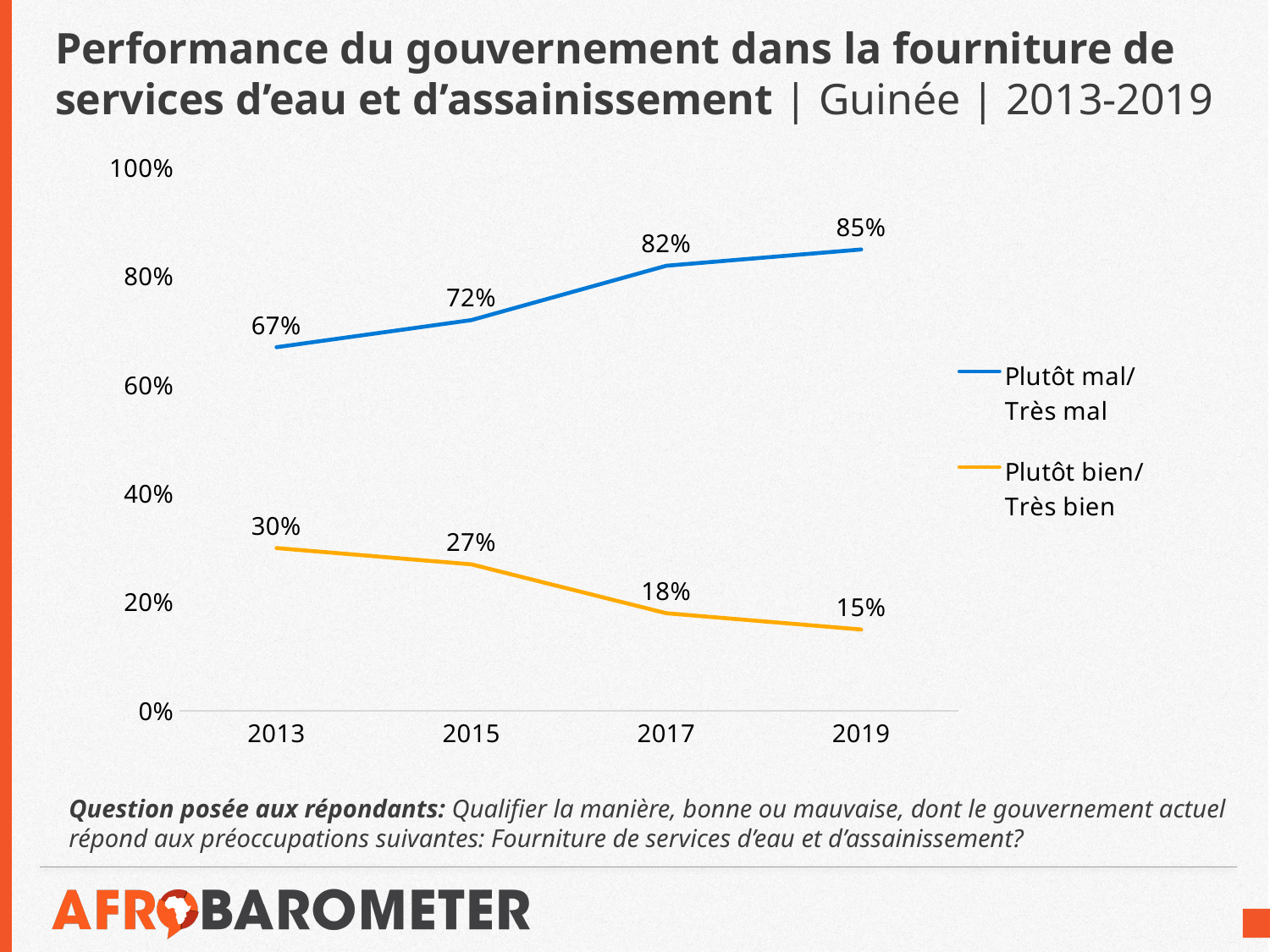
What is the value for 'Plutôt bien/Très bien' in 2013? 30% How many years are plotted on the x axis? 4 Does the 'Plutôt bien/Très bien' line rise or fall from 2013 to 2019? Fall By how much did 'Plutôt mal/Très mal' increase from 2013 to 2019? 18% In which year is 'Plutôt mal/Très mal' highest? 2019 What is the value for 'Plutôt mal/Très mal' in 2019? 85% What is the difference between 'Plutôt mal/Très mal' and 'Plutôt bien/Très bien' in 2017? 64% Which is larger in 2015: 'Plutôt mal/Très mal' or 'Plutôt bien/Très bien'? Plutôt mal/Très mal What is the value for 'Plutôt mal/Très mal' in 2015? 72% What kind of chart is shown on the slide? Line chart How many series does the legend list? 2 In which year is 'Plutôt bien/Très bien' lowest? 2019